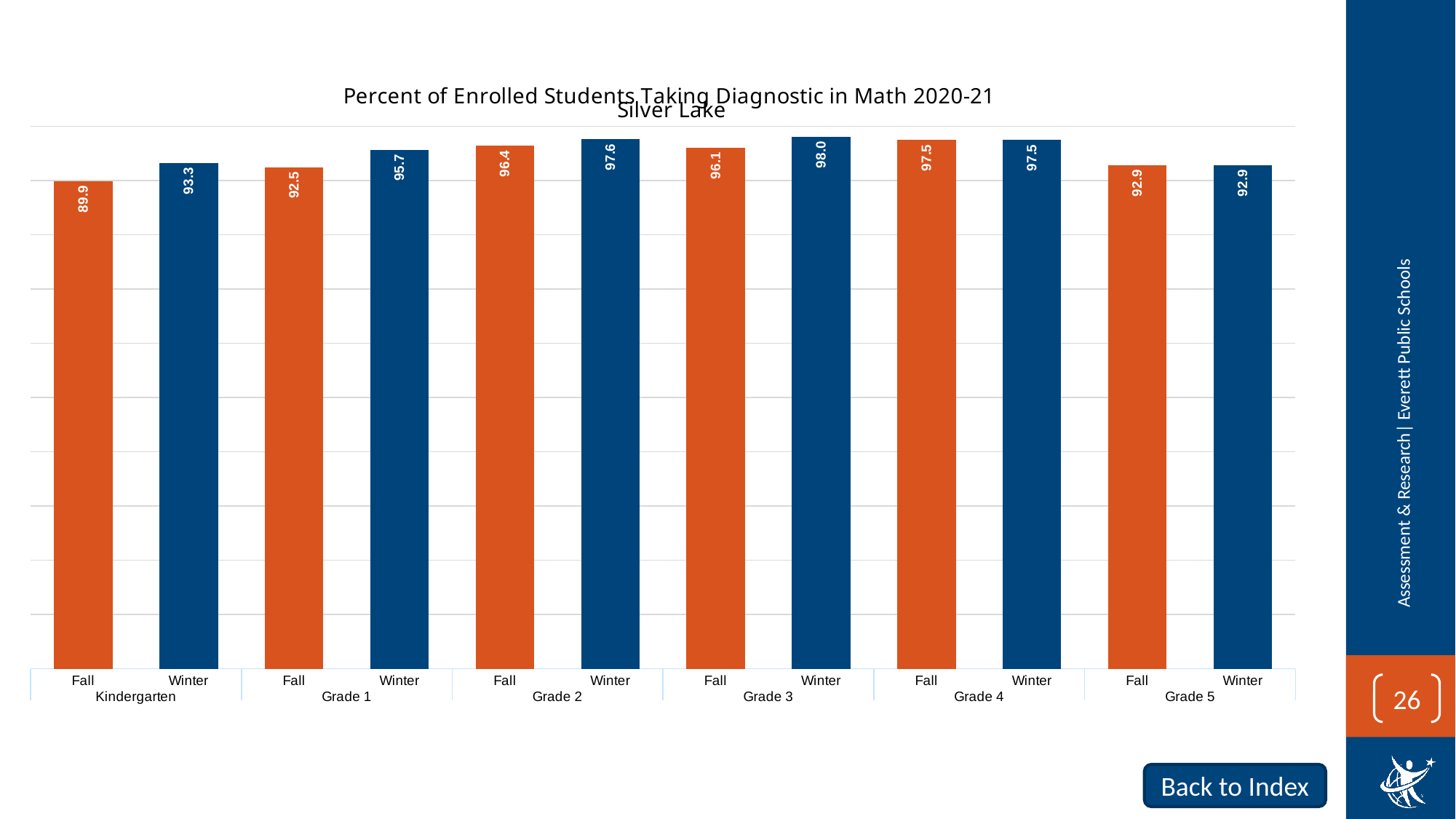
What is the value for Fall in Grade 5? 92.9 What kind of chart is shown on the slide? Bar chart Which bar has the highest value? Grade 3 Winter What is the value for Fall in Kindergarten? 89.9 Which bar has the lowest value? Kindergarten Fall What is the title of the chart? Percent of Enrolled Students Taking Diagnostic in Math 2020-21 Silver Lake Which is larger, Fall in Grade 2 or Fall in Grade 3? Fall in Grade 2 Which is larger, Winter in Grade 1 or Winter in Grade 2? Winter in Grade 2 What is the difference between Winter and Fall in Kindergarten? 3.4 What is the difference between Winter and Fall in Grade 1? 3.2 How many grade levels are shown on the x axis? 6 What is the value for Winter in Grade 3? 98.0